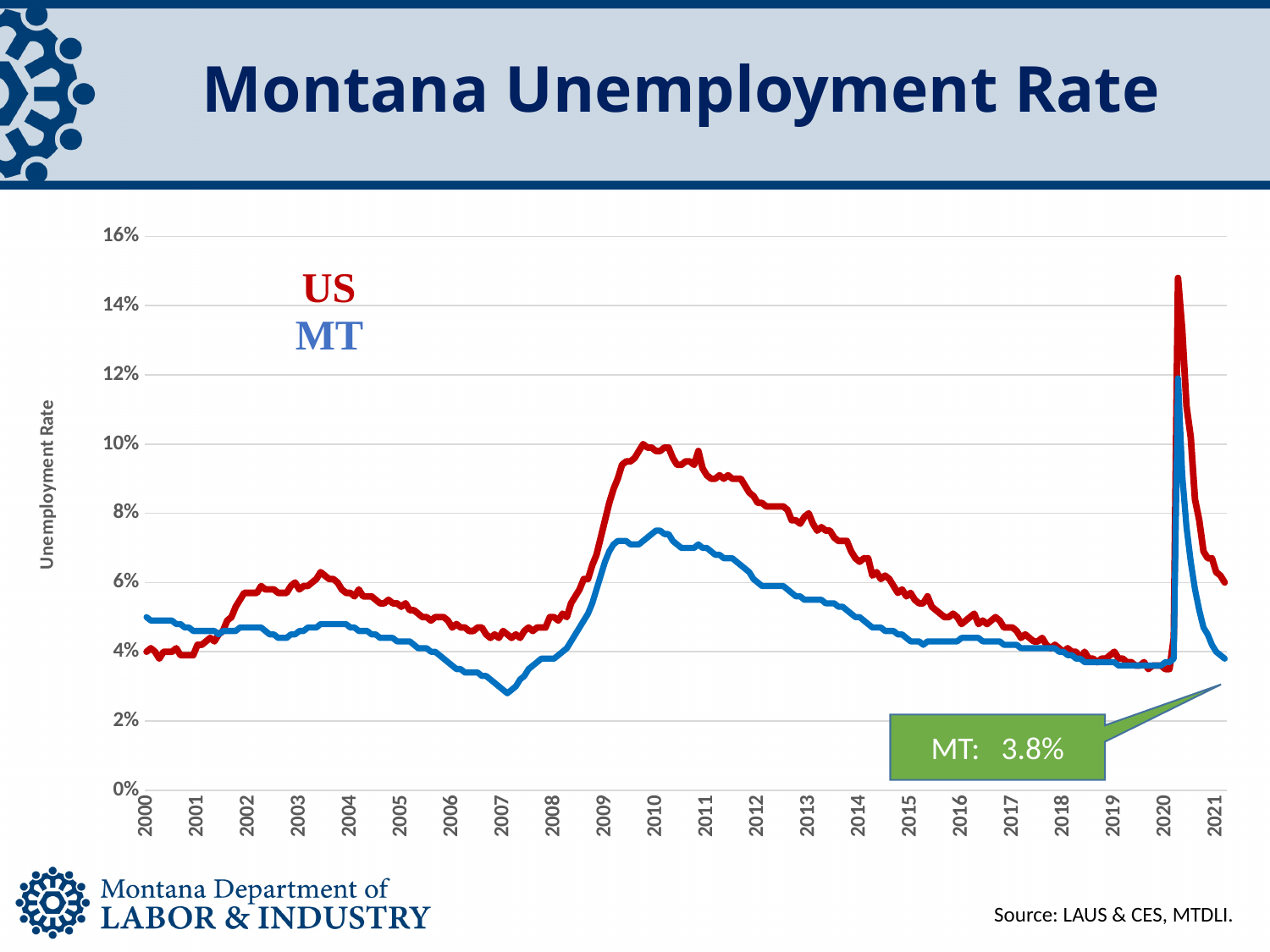
How many series does the chart show? 2 What is the title of the chart? Montana Unemployment Rate Is the value for the US series around 2010 greater or less than 8%? greater At the start of 2000, which series has the higher unemployment rate, US or MT? MT What is the MT unemployment rate shown in the callout label at the end of the series? 3.8% Is the peak value of the MT series in 2020 greater or less than 10%? greater Around 2010, which series has the higher unemployment rate, US or MT? US Which series reaches the highest value on the chart? US Is the lowest value of the MT series around 2007 greater or less than 4%? less What kind of chart is shown on the slide? Line chart Between 2010 and 2019, does the US unemployment rate rise or fall? Fall